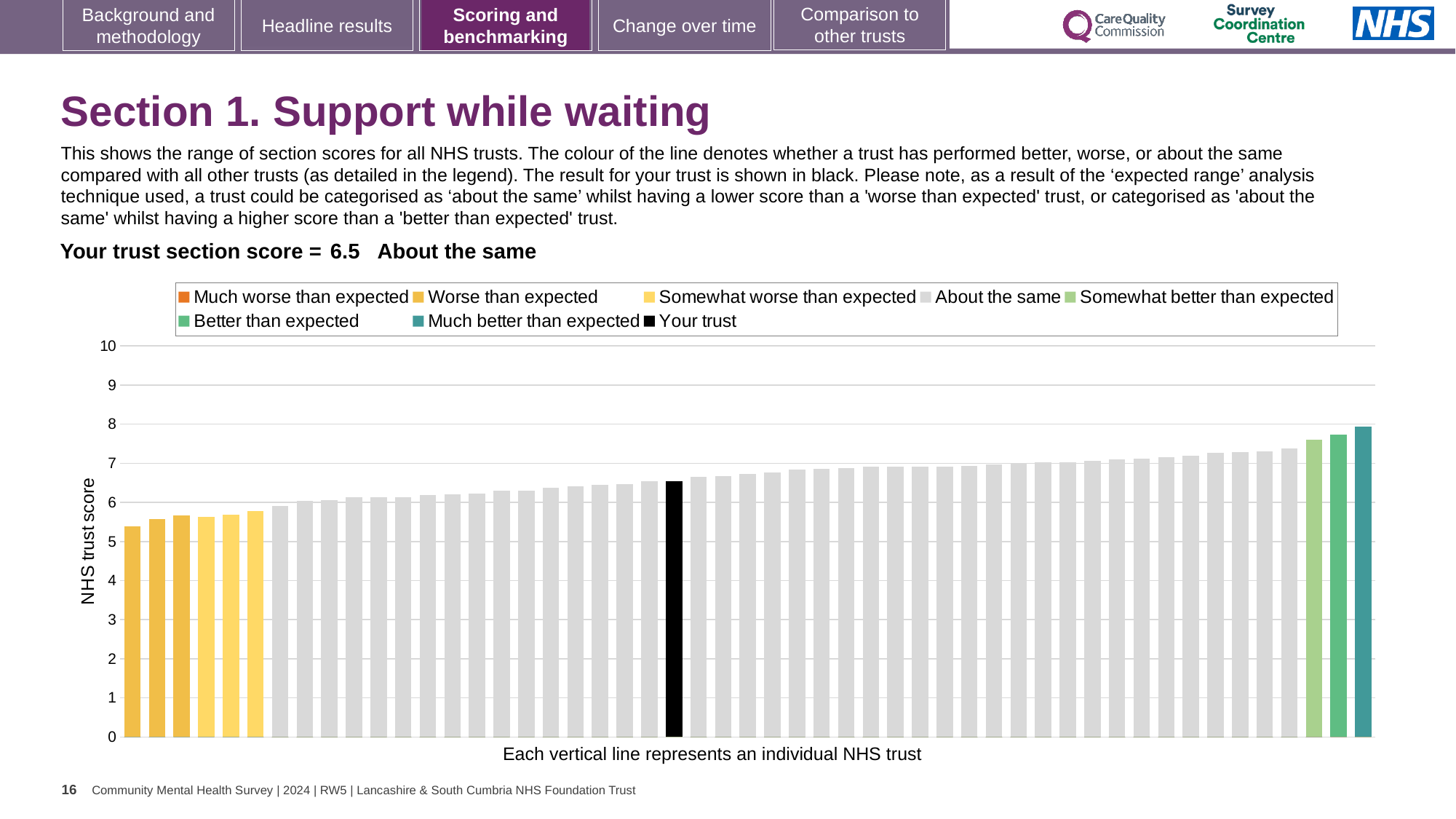
Is the value of the tallest bar greater or less than 7? greater What kind of chart is shown on the slide? bar chart Is the value of the shortest bar greater or less than 5? greater Is the value of the black bar (your trust) greater or less than 7? less What is the label on the vertical axis of the chart? NHS trust score Which performance category is the trust placed in for this section? About the same What is the label below the horizontal axis of the chart? Each vertical line represents an individual NHS trust What is the trust's section score for Support while waiting? 6.5 How many entries does the chart legend list? 8 Do the bar values rise or fall from left to right along the x axis? rise